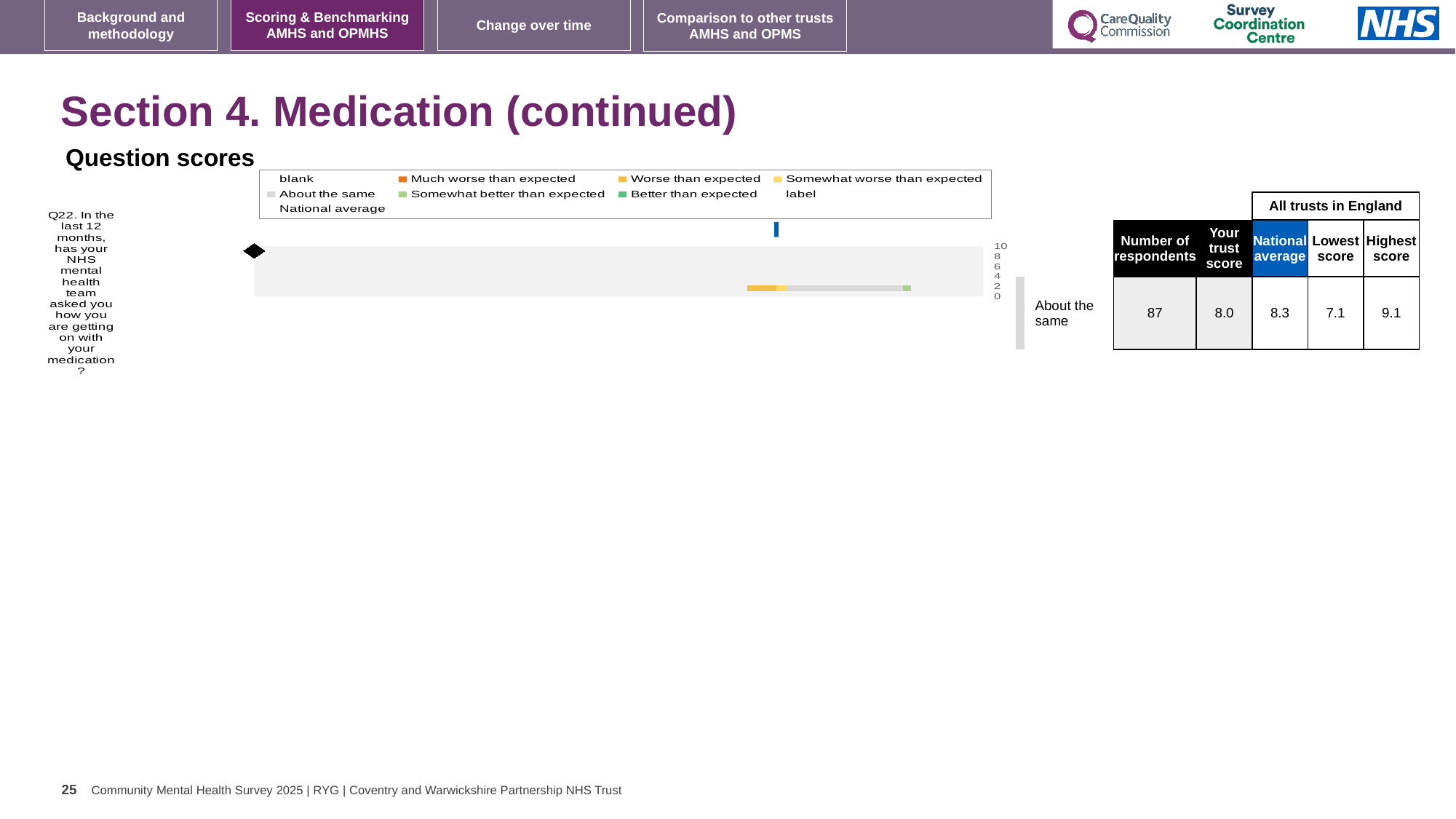
What kind of chart is used to show the Q22 question score? bar chart What is the lowest score among all trusts in England for Q22? 7.1 What is the maximum value shown on the score axis of the chart? 10 What is the national average score for Q22? 8.3 What is the highest score among all trusts in England for Q22? 9.1 What is the trust score for Q22 (asked how you are getting on with your medication)? 8.0 Which benchmark category is Q22 placed in? About the same How many respondents answered Q22? 87 How many questions are plotted on the chart? 1 How many entries does the chart legend list? 9 What is the difference between the highest and lowest trust scores for Q22? 2.0 Which is larger for Q22, the trust score or the national average? National average